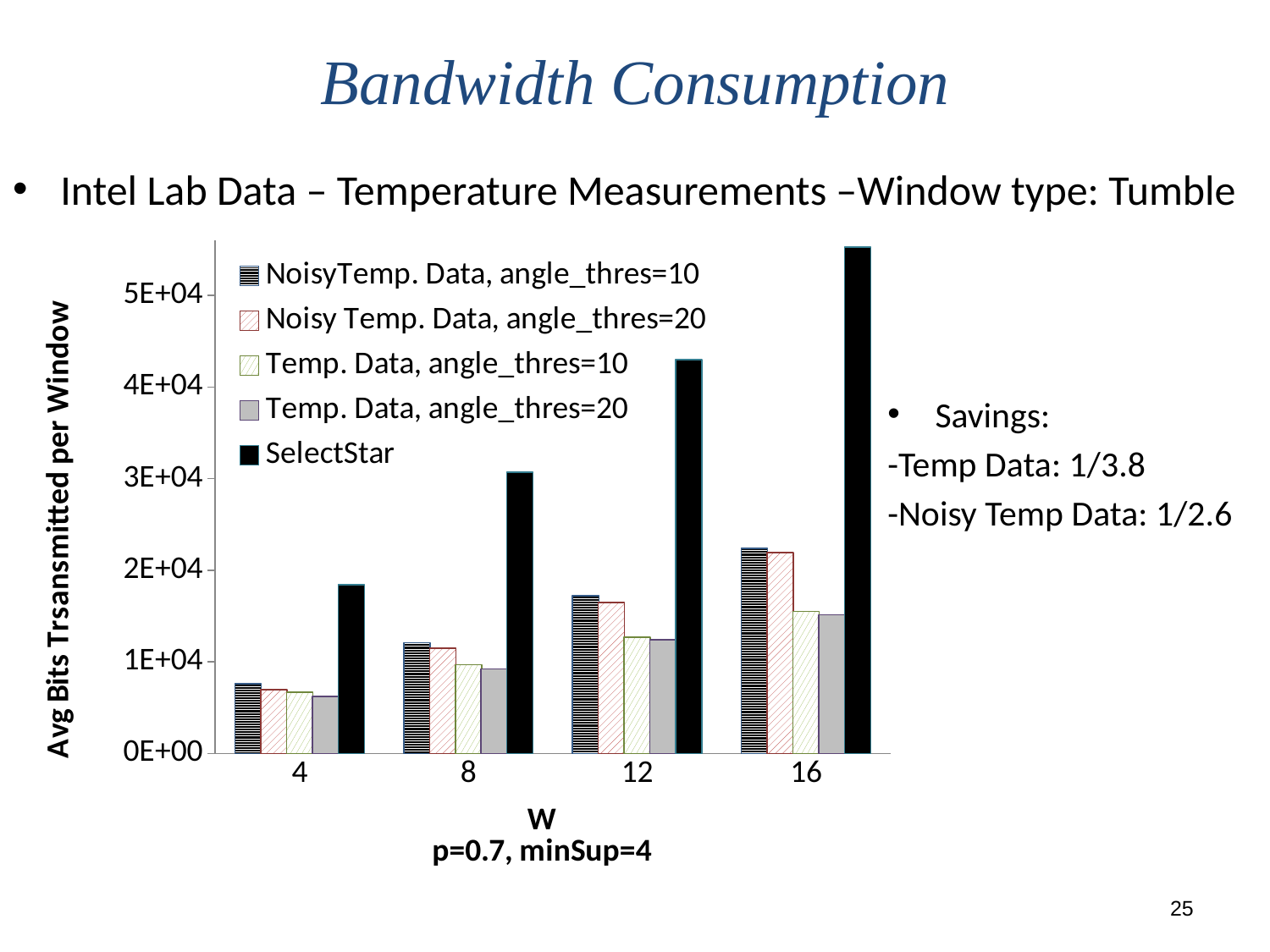
Is the value for SelectStar at W=16 greater or less than 5E+04? greater What is the label of the x axis? W Is the value for SelectStar at W=4 greater or less than 2E+04? less Do the SelectStar values rise or fall as W increases from 4 to 16? rise Which is larger at W=16: SelectStar or Temp. Data, angle_thres=20? SelectStar How many W values (categories) are shown on the x axis? 4 How many series does the legend list? 5 Is the value for NoisyTemp. Data, angle_thres=10 at W=4 greater or less than 1E+04? less Which series has the tallest bar at W=16? SelectStar What kind of chart is shown on the slide? bar chart What is the label of the y axis? Avg Bits Trsansmitted per Window